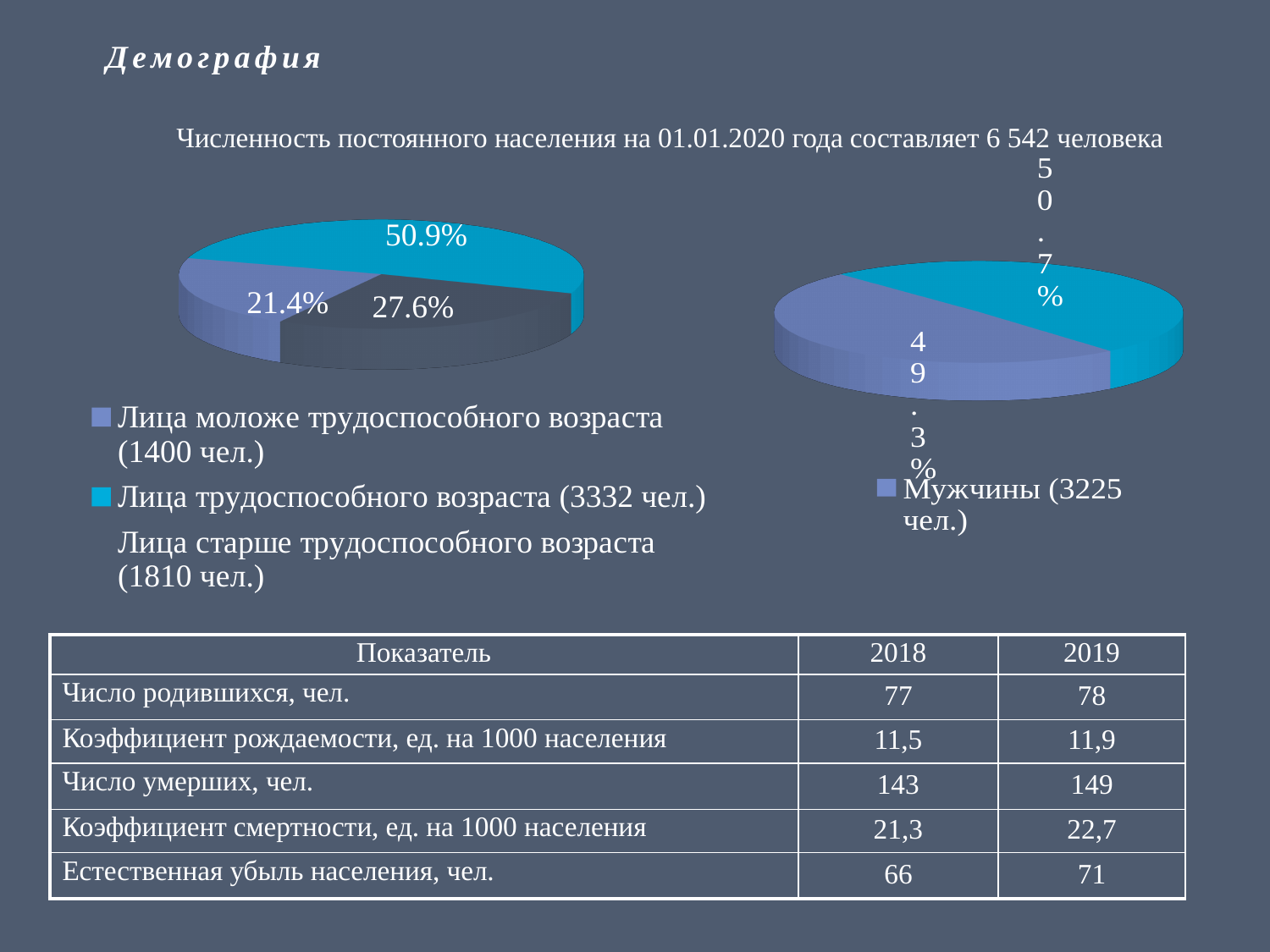
On the left pie chart, what share is shown for Лица трудоспособного возраста? 50.9% On the left pie chart, what is the difference in percentage points between the slices for Лица трудоспособного возраста and Лица моложе трудоспособного возраста? 29.5 On the left pie chart, which slice is larger: Лица старше трудоспособного возраста or Лица моложе трудоспособного возраста? Лица старше трудоспособного возраста On the left pie chart, how many people are in the legend entry for Лица трудоспособного возраста? 3332 чел. What type of chart is the left chart on the slide? Pie chart On the right pie chart, how many people does the legend give for Мужчины? 3225 чел. How many slices does the left pie chart have? 3 On the right pie chart, what share is shown for Мужчины? 49.3% On the left pie chart, which category has the smallest slice? Лица моложе трудоспособного возраста On the left pie chart, which category has the largest slice? Лица трудоспособного возраста On the left pie chart, what share is shown for Лица моложе трудоспособного возраста? 21.4% On the left pie chart, what share is shown for Лица старше трудоспособного возраста? 27.6%